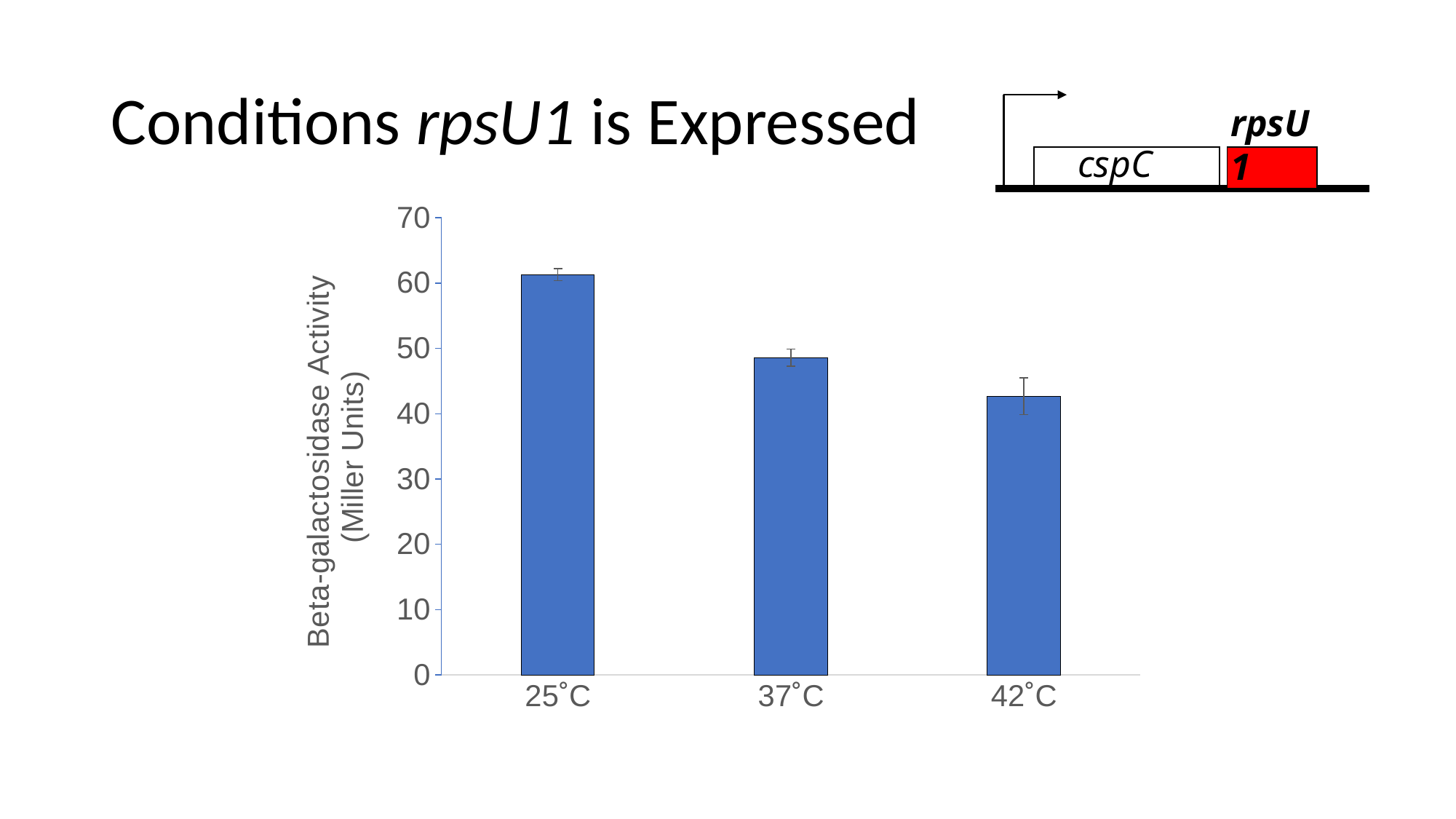
Is the beta-galactosidase activity at 25˚C greater or less than 60? greater Which has higher beta-galactosidase activity, 37˚C or 42˚C? 37˚C Is the beta-galactosidase activity at 37˚C greater or less than 50? less Which temperature has the lowest beta-galactosidase activity? 42˚C Which temperature has the highest beta-galactosidase activity? 25˚C What is the label of the y axis? Beta-galactosidase Activity (Miller Units) Is the beta-galactosidase activity at 42˚C greater or less than 40? greater What kind of chart is shown on the slide? bar chart What is the maximum value shown on the y axis? 70 Do the values rise or fall as temperature increases along the x axis? fall How many temperature categories are plotted on the x axis? 3